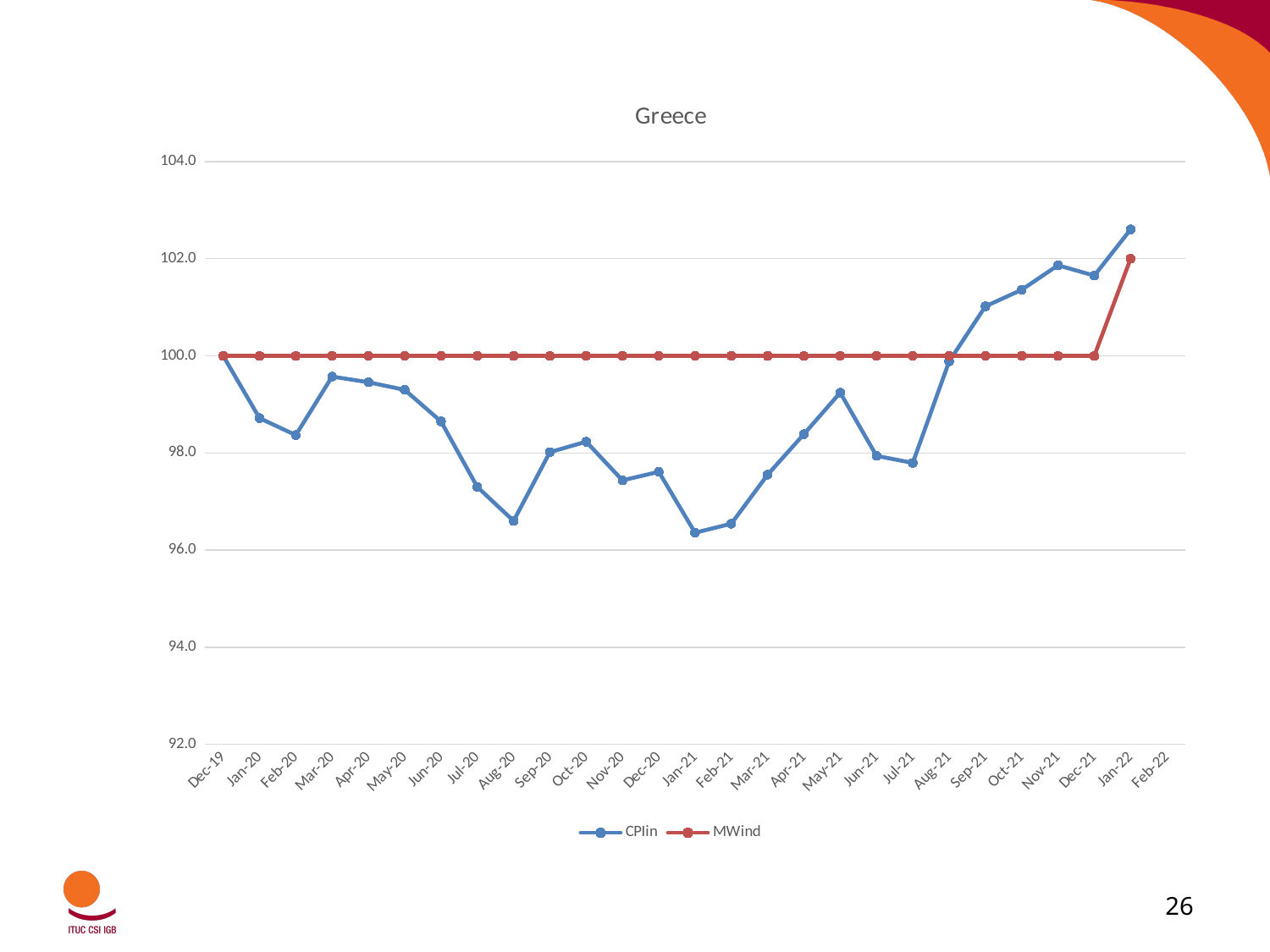
What is the value of MWind in Jun-20? 100.0 In Sep-21, which series has the higher value, CPIin or MWind? CPIin In which month does CPIin reach its highest value? Jan-22 Is the value of CPIin in Jan-22 greater or less than 102.0? greater What is the value of CPIin in Dec-19? 100.0 What is the value of MWind in Jan-22? 102.0 How many series does the legend list? 2 Is the value of CPIin in Jan-21 greater or less than 98.0? less Does CPIin rise or fall between Aug-21 and Jan-22? rise What is the title of the chart? Greece Which series is drawn in red? MWind What kind of chart is shown on the slide? line chart